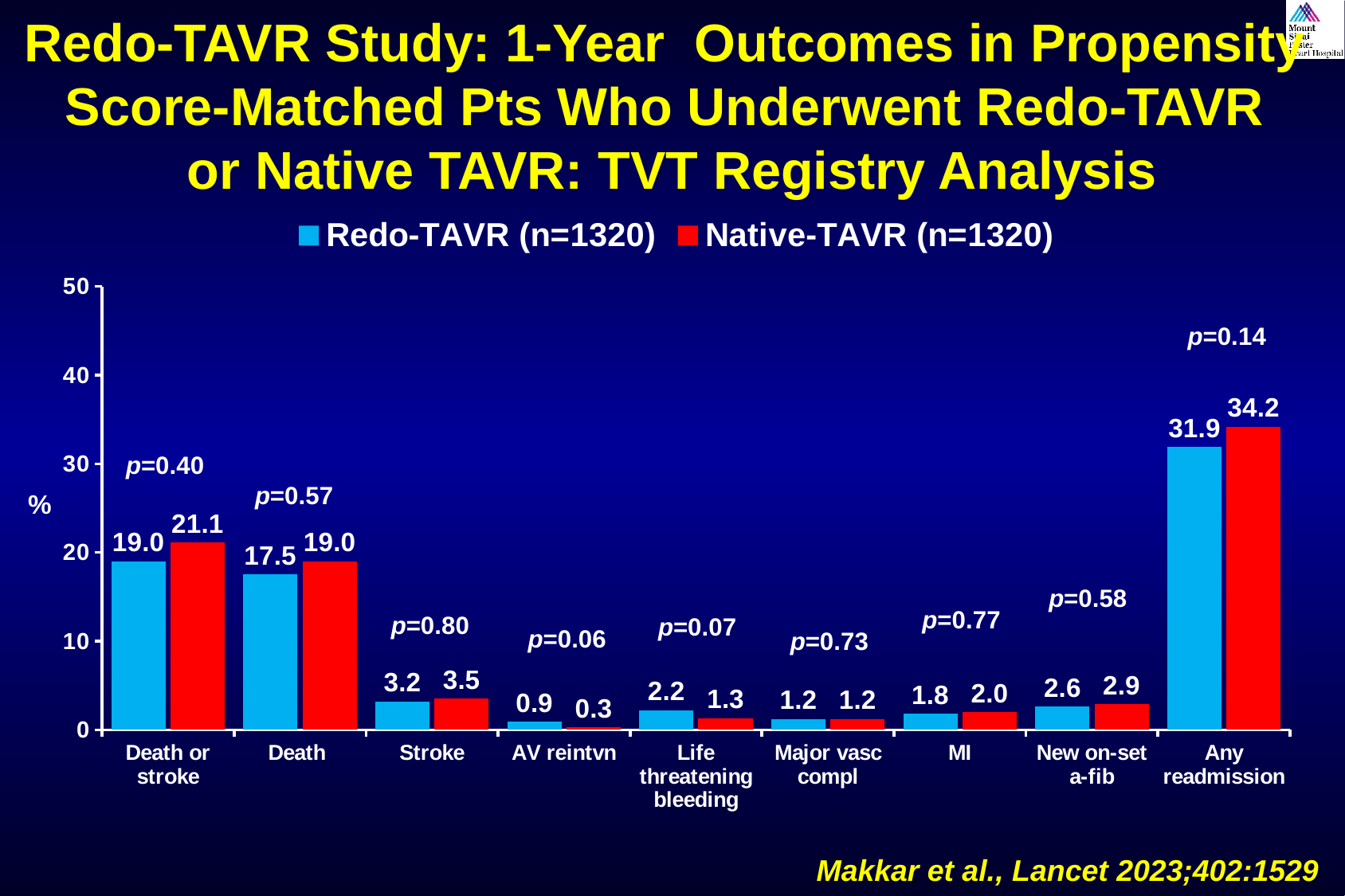
Which category has the lowest Native-TAVR value? AV reintvn Which is larger for Life threatening bleeding, the Redo-TAVR value or the Native-TAVR value? Redo-TAVR What is the Redo-TAVR value for AV reintvn? 0.9 How many categories are shown on the x axis? 9 What is the Native-TAVR value for Death or stroke? 21.1 Which category has the highest Native-TAVR value? Any readmission What is the difference between the Native-TAVR and Redo-TAVR values for Any readmission? 2.3 What kind of chart is shown on the slide? Bar chart What is the p-value shown for Any readmission? p=0.14 What is the Redo-TAVR value for Any readmission? 31.9 How many series does the legend list? 2 What colour represents Native-TAVR in the legend? Red